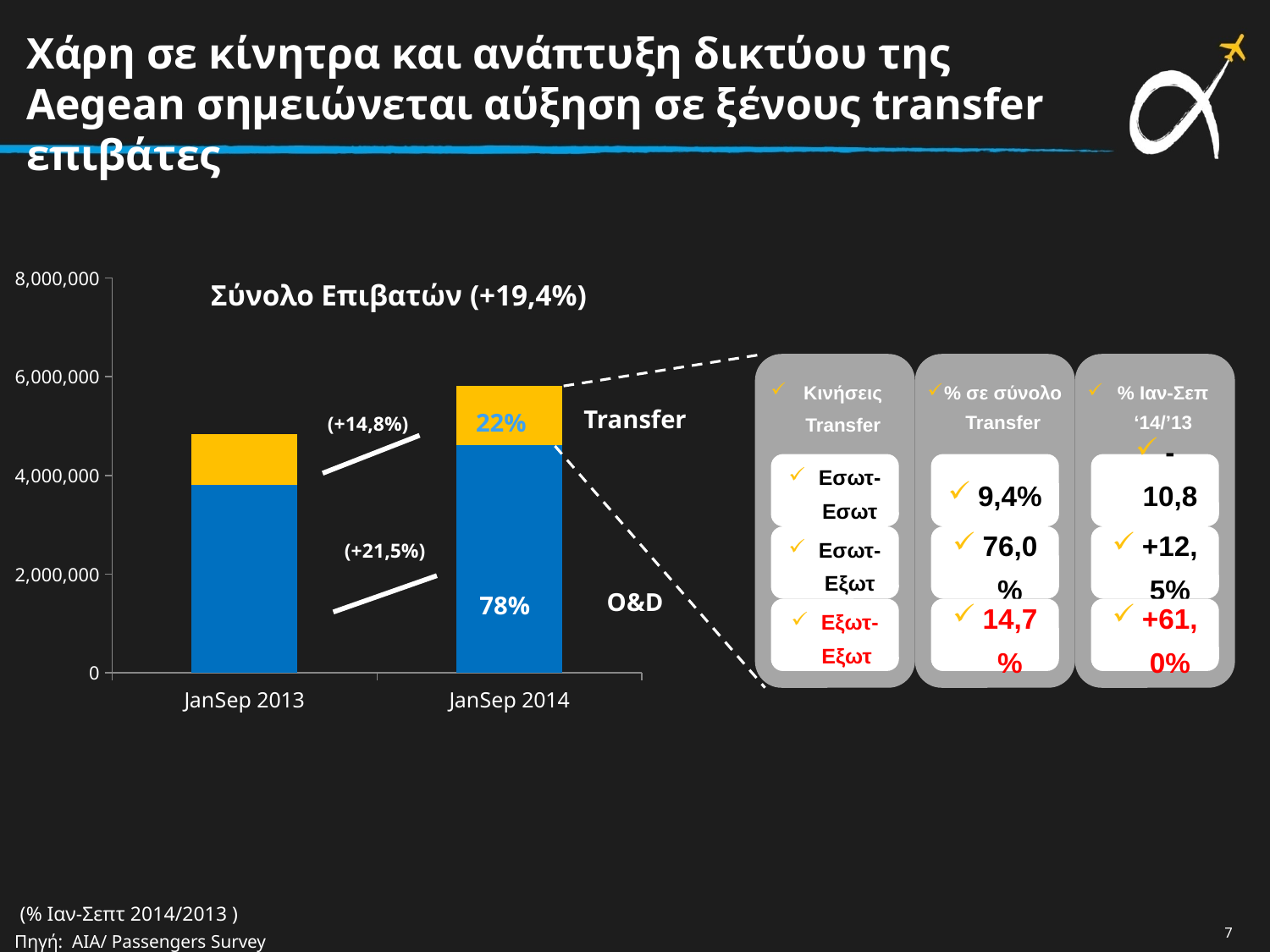
What growth percentage is annotated for the Transfer segment between the two bars? (+14,8%) Is the total value of the JanSep 2014 bar greater or less than 6,000,000? less Which bar is taller, JanSep 2013 or JanSep 2014? JanSep 2014 How many categories are shown on the x axis of the chart? 2 Do the total passenger values rise or fall from JanSep 2013 to JanSep 2014? rise What percentage of the JanSep 2014 bar is labelled as O&D? 78% Is the O&D (blue) portion of the JanSep 2014 bar greater or less than 4,000,000? greater What percentage of the JanSep 2014 bar is labelled as Transfer? 22% What growth percentage is annotated for the O&D segment between the two bars? (+21,5%) Is the total value of the JanSep 2013 bar greater or less than 4,000,000? greater What is the title of the chart? Σύνολο Επιβατών (+19,4%) What kind of chart is shown on the slide? Stacked bar chart